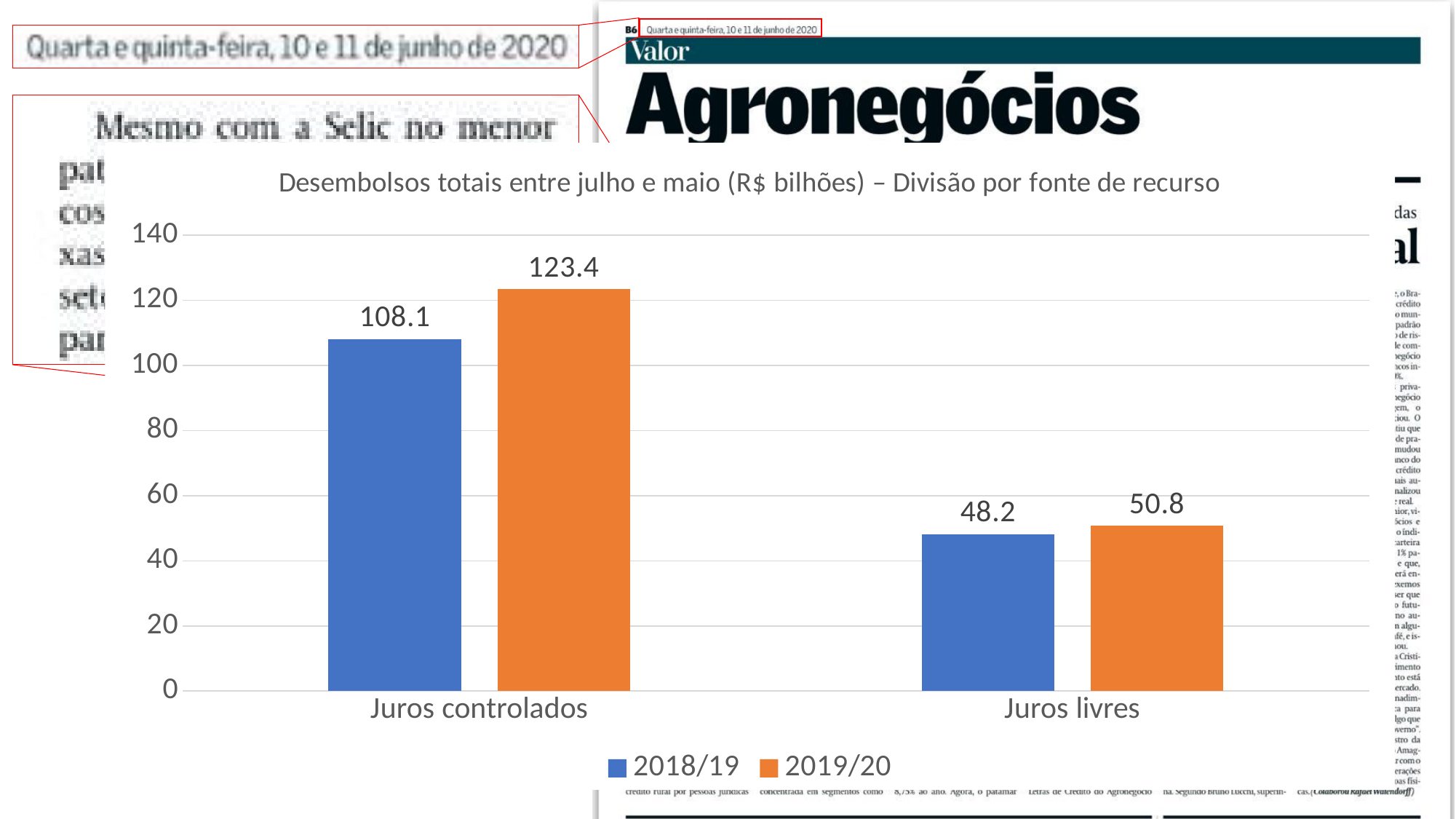
What is the difference between the 2019/20 and 2018/19 values for Juros livres? 2.6 What is the difference between the 2019/20 and 2018/19 values for Juros controlados? 15.3 What is the value for Juros controlados in the 2018/19 series? 108.1 Which category has the highest value in the 2019/20 series? Juros controlados Which is larger for Juros livres: the 2018/19 value or the 2019/20 value? 2019/20 How many categories are shown on the x axis? 2 How many series does the legend list? 2 Which category has the lowest value in the 2018/19 series? Juros livres What is the value for Juros livres in the 2018/19 series? 48.2 What kind of chart is shown on the slide? Bar chart What is the value for Juros controlados in the 2019/20 series? 123.4 What is the value for Juros livres in the 2019/20 series? 50.8